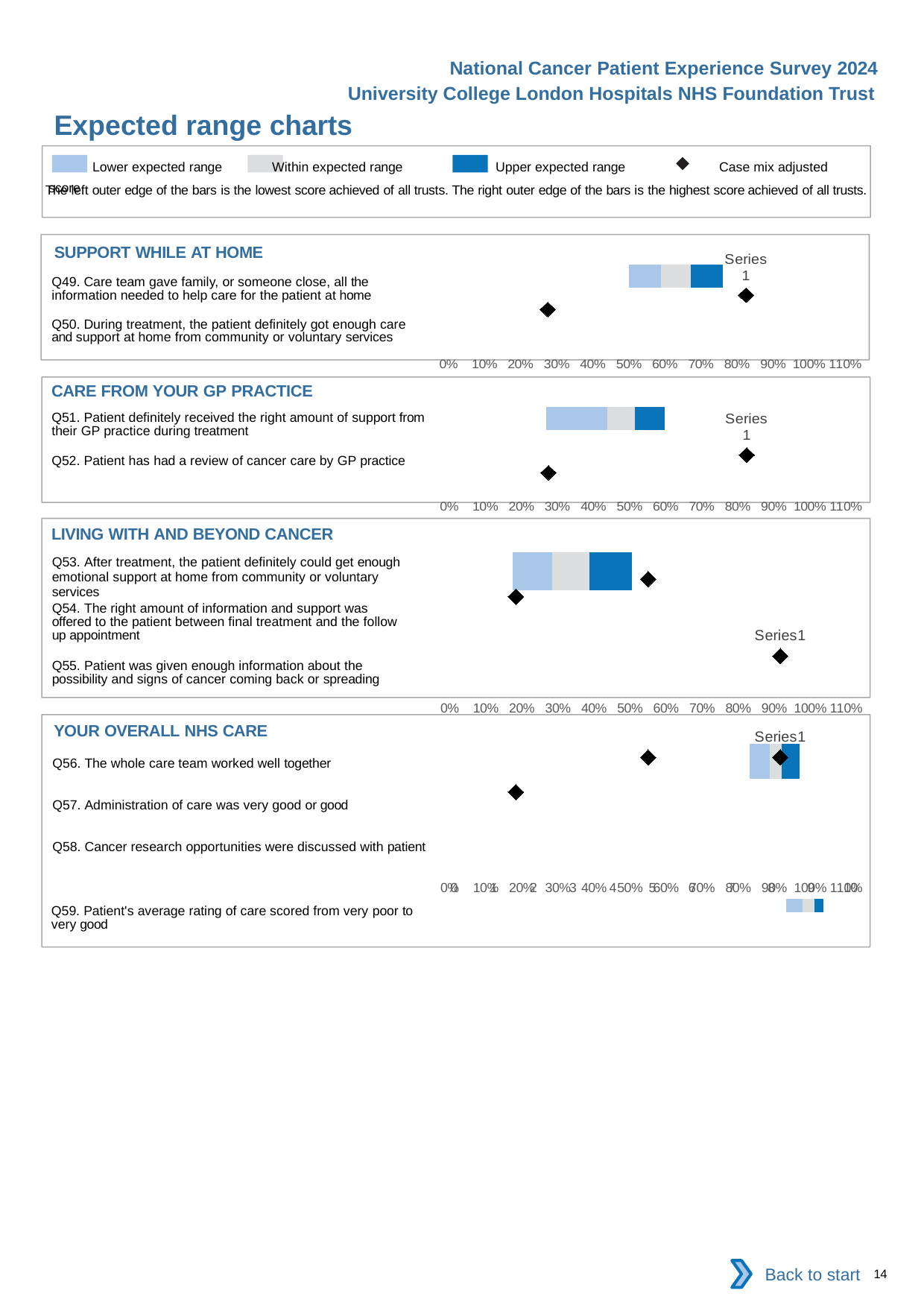
How many questions are listed in the SUPPORT WHILE AT HOME chart? 2 How many entries does the legend at the top of the slide list? 4 According to the legend, what does the black diamond marker represent? Case mix adjusted score How many questions are listed in the LIVING WITH AND BEYOND CANCER chart? 3 What kind of chart is used in the SUPPORT WHILE AT HOME section? Bar chart In the LIVING WITH AND BEYOND CANCER chart, is the left edge of the expected range bar greater or less than 30%? less How many questions are listed in the CARE FROM YOUR GP PRACTICE chart? 2 In the SUPPORT WHILE AT HOME chart, is the left edge of the expected range bar greater or less than 40%? greater In the CARE FROM YOUR GP PRACTICE chart, is the right edge of the expected range bar greater or less than 70%? less According to the legend, what does the light blue segment of a bar represent? Lower expected range